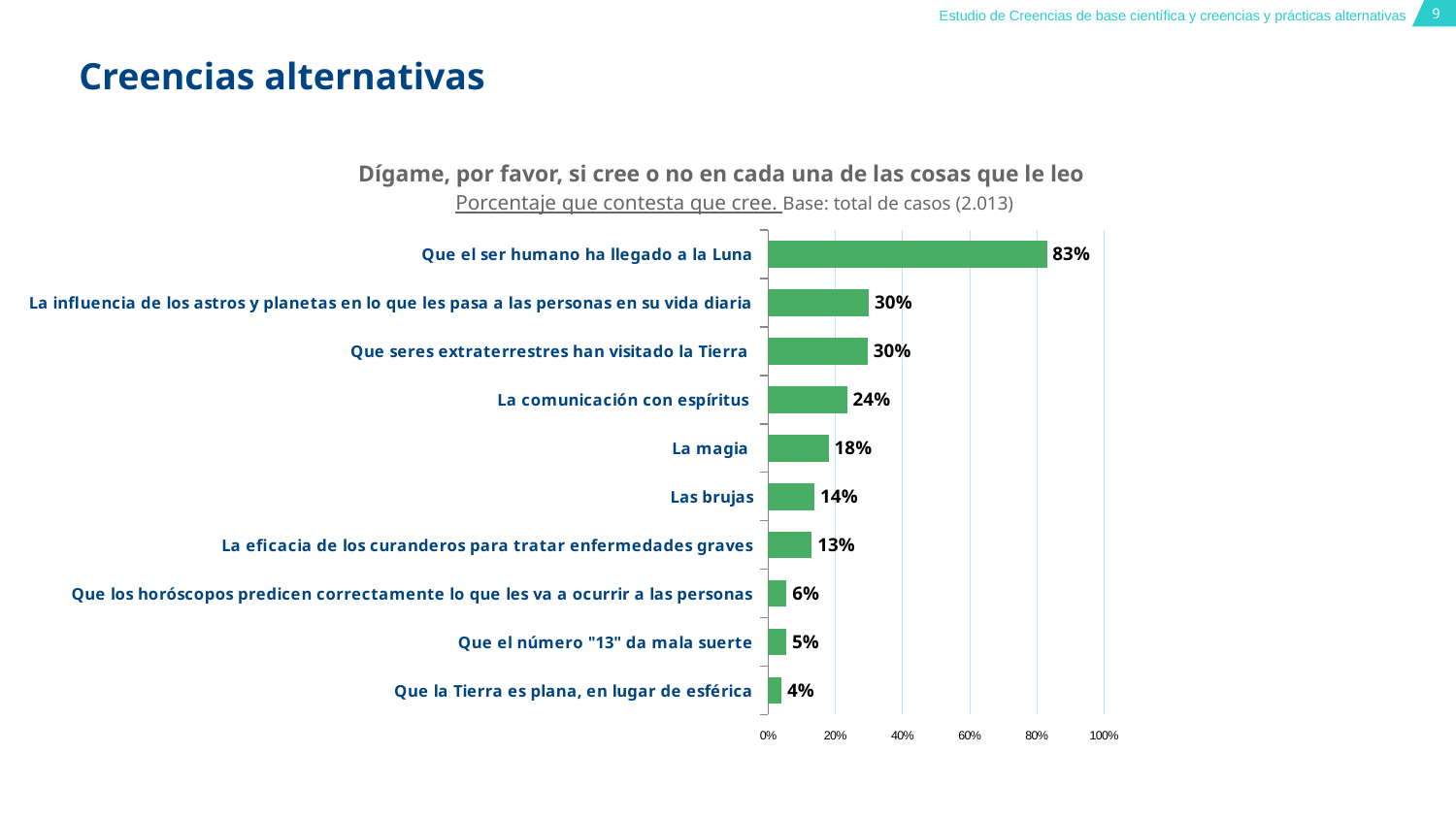
What is the difference between the value for 'Que el ser humano ha llegado a la Luna' and the value for 'Que la Tierra es plana, en lugar de esférica'? 79% Is the value for 'Que seres extraterrestres han visitado la Tierra' greater or less than 20%? greater What is the difference between the value for 'La magia' and the value for 'Las brujas'? 4% Which category has the highest percentage? Que el ser humano ha llegado a la Luna How many categories are shown in the chart? 10 What percentage of respondents say they believe that humans have reached the Moon (Que el ser humano ha llegado a la Luna)? 83% Which is larger: the value for 'La comunicación con espíritus' or the value for 'La eficacia de los curanderos para tratar enfermedades graves'? La comunicación con espíritus Which category has the lowest percentage? Que la Tierra es plana, en lugar de esférica What percentage believe in 'Las brujas'? 14% What kind of chart is shown on the slide? Bar chart What is the value for 'La comunicación con espíritus'? 24% What is the base (number of cases) stated in the chart subtitle? 2.013